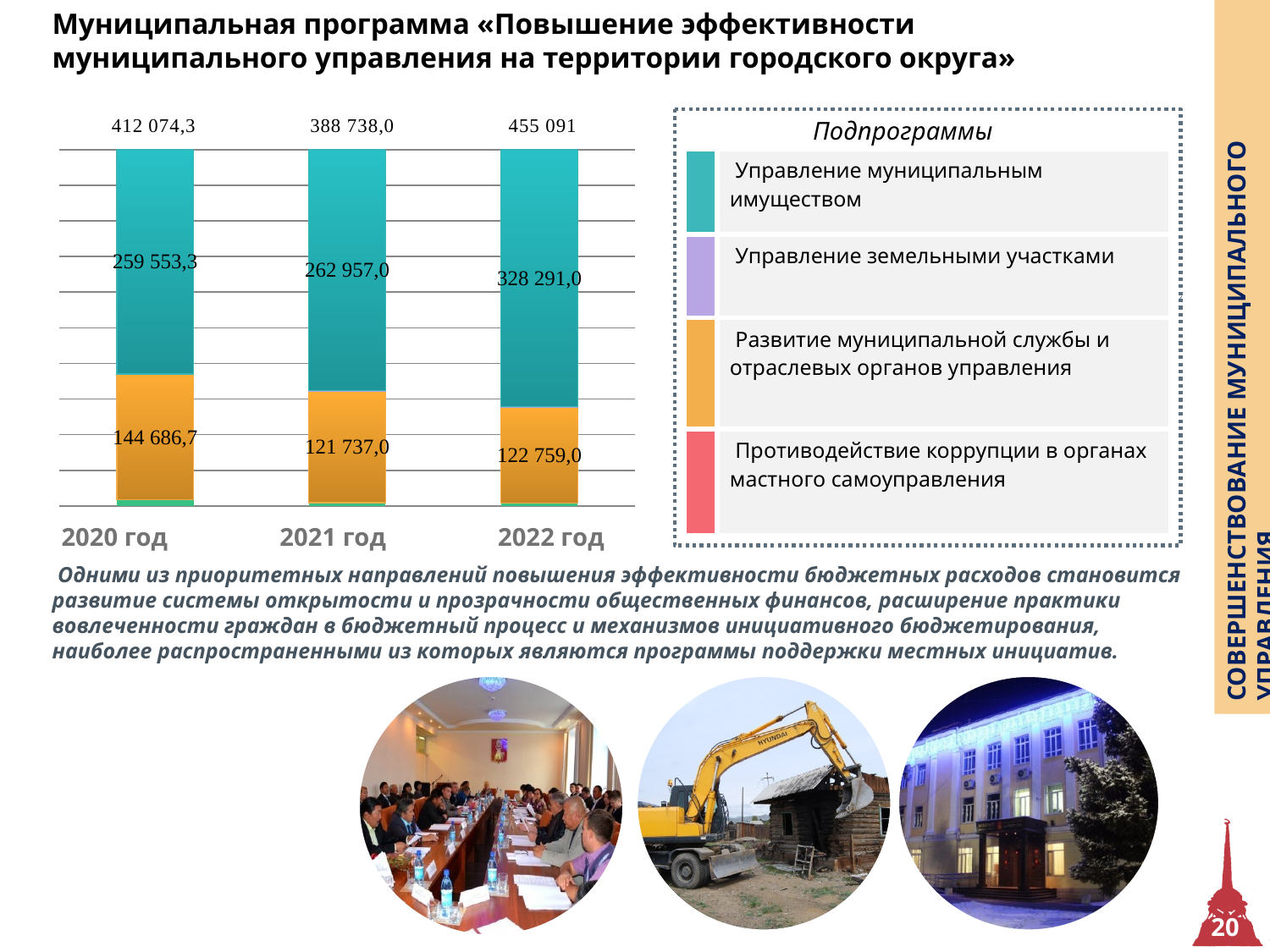
Which is larger: the orange segment (Развитие муниципальной службы) for 2020 год or for 2021 год? 2020 год What is the value of the teal segment (Управление муниципальным имуществом) for 2022 год? 328 291,0 What is the value of the orange segment (Развитие муниципальной службы и отраслевых органов управления) for 2021 год? 121 737,0 What kind of chart is shown on the slide? stacked bar chart How many subprograms does the legend «Подпрограммы» list? 4 Does the teal segment (Управление муниципальным имуществом) rise or fall from 2020 год to 2022 год? rise Which year has the highest total value printed above its bar? 2022 год By how much does the teal segment (Управление муниципальным имуществом) for 2022 год exceed that for 2021 год? 65 334,0 Which year has the lowest total value printed above its bar? 2021 год What is the total value printed above the bar for 2020 год? 412 074,3 What is the difference between the total for 2022 год and the total for 2020 год? 43 016,7 How many years (categories) are shown on the x axis of the chart? 3